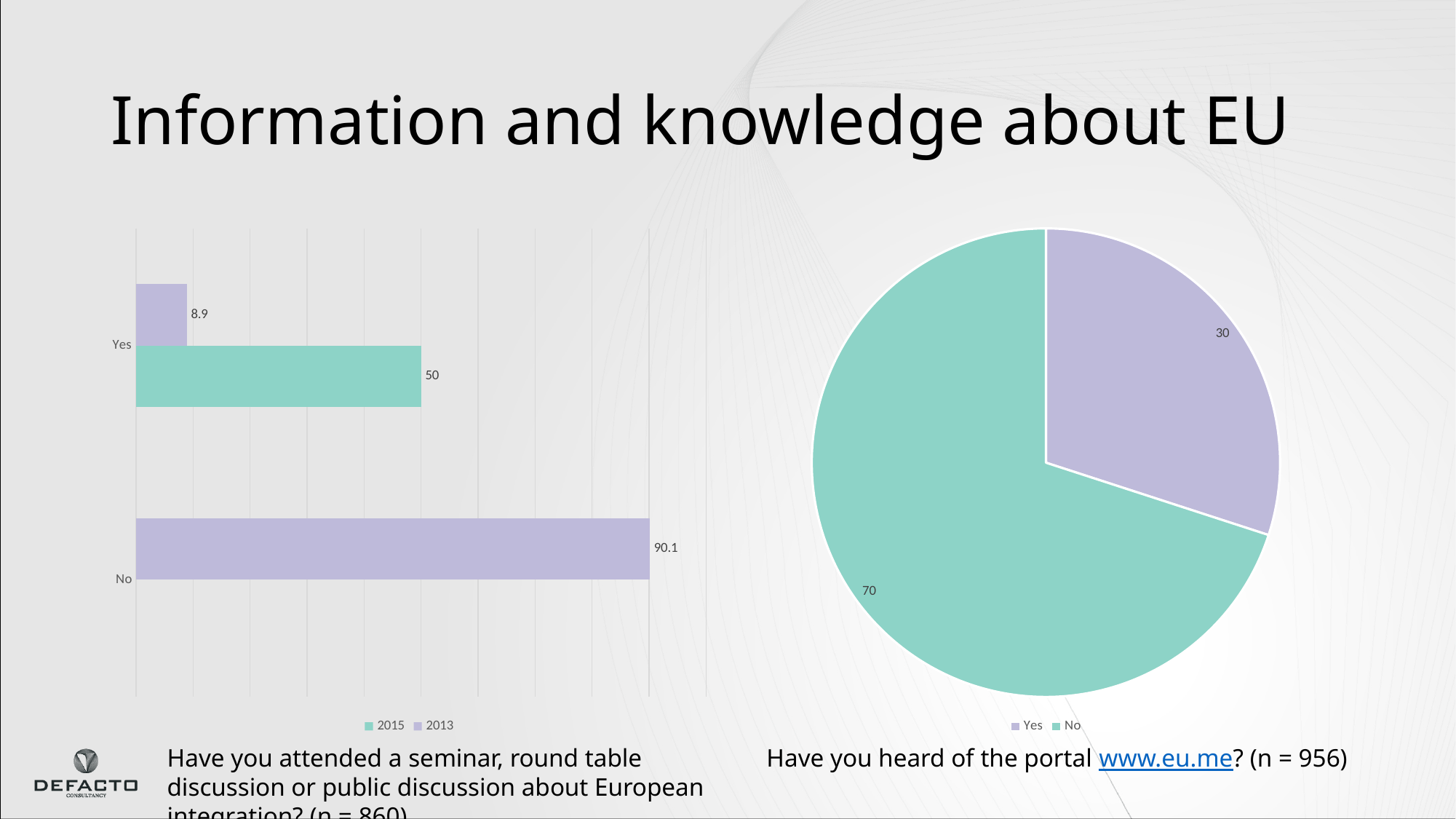
What kind of chart is the chart on the right? Pie chart In the pie chart on the right, which slice is the largest? No In the bar chart on the left, what is the value for Yes in 2013? 8.9 In the pie chart on the right, what is the value for No? 70 In the bar chart on the left, how many series does the legend list? 2 In the bar chart on the left, which is larger for Yes: the 2015 value or the 2013 value? 2015 In the bar chart on the left, what is the value for No in 2013? 90.1 In the bar chart on the left, what is the difference between the 2013 values for No and Yes? 81.2 In the pie chart on the right, what colour is the Yes slice? Purple What kind of chart is the chart on the left? Bar chart In the bar chart on the left, what is the value for Yes in 2015? 50 In the pie chart on the right, what is the value for Yes? 30